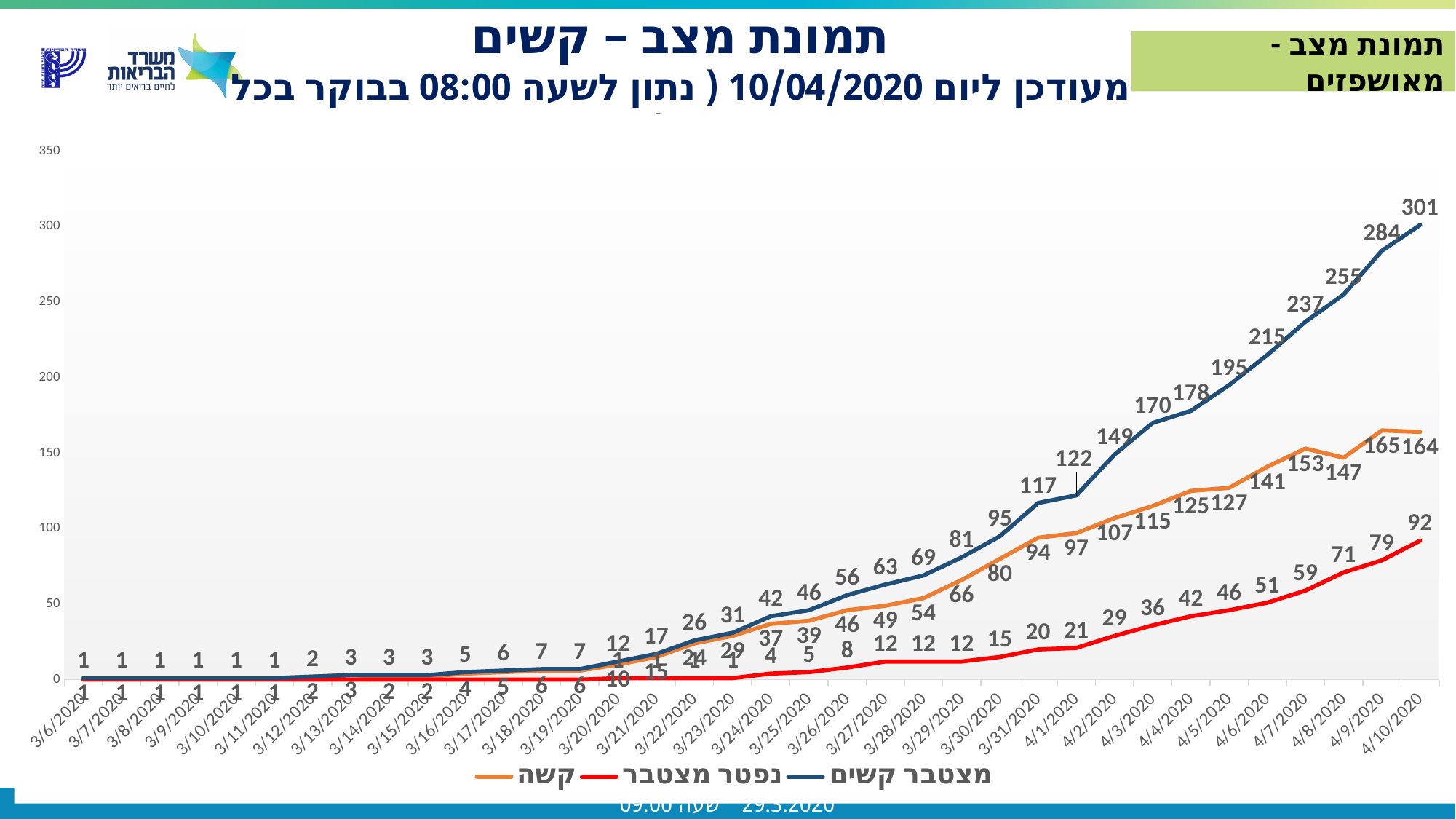
Does the מצטבר קשים series rise or fall from 3/6/2020 to 4/10/2020? rise What is the value of מצטבר קשים on 4/1/2020? 122 What is the value of קשה on 4/9/2020? 165 What colour is the line for נפטר מצטבר? red On which date does מצטבר קשים reach its highest value? 4/10/2020 What is the value of מצטבר קשים on 4/10/2020? 301 How many series does the legend list? 3 What type of chart is shown on the slide? line chart How many dates are shown on the x axis? 36 Which is larger on 4/8/2020: קשה or נפטר מצטבר? קשה What is the value of נפטר מצטבר on 4/10/2020? 92 What is the difference between מצטבר קשים on 4/10/2020 and on 4/9/2020? 17